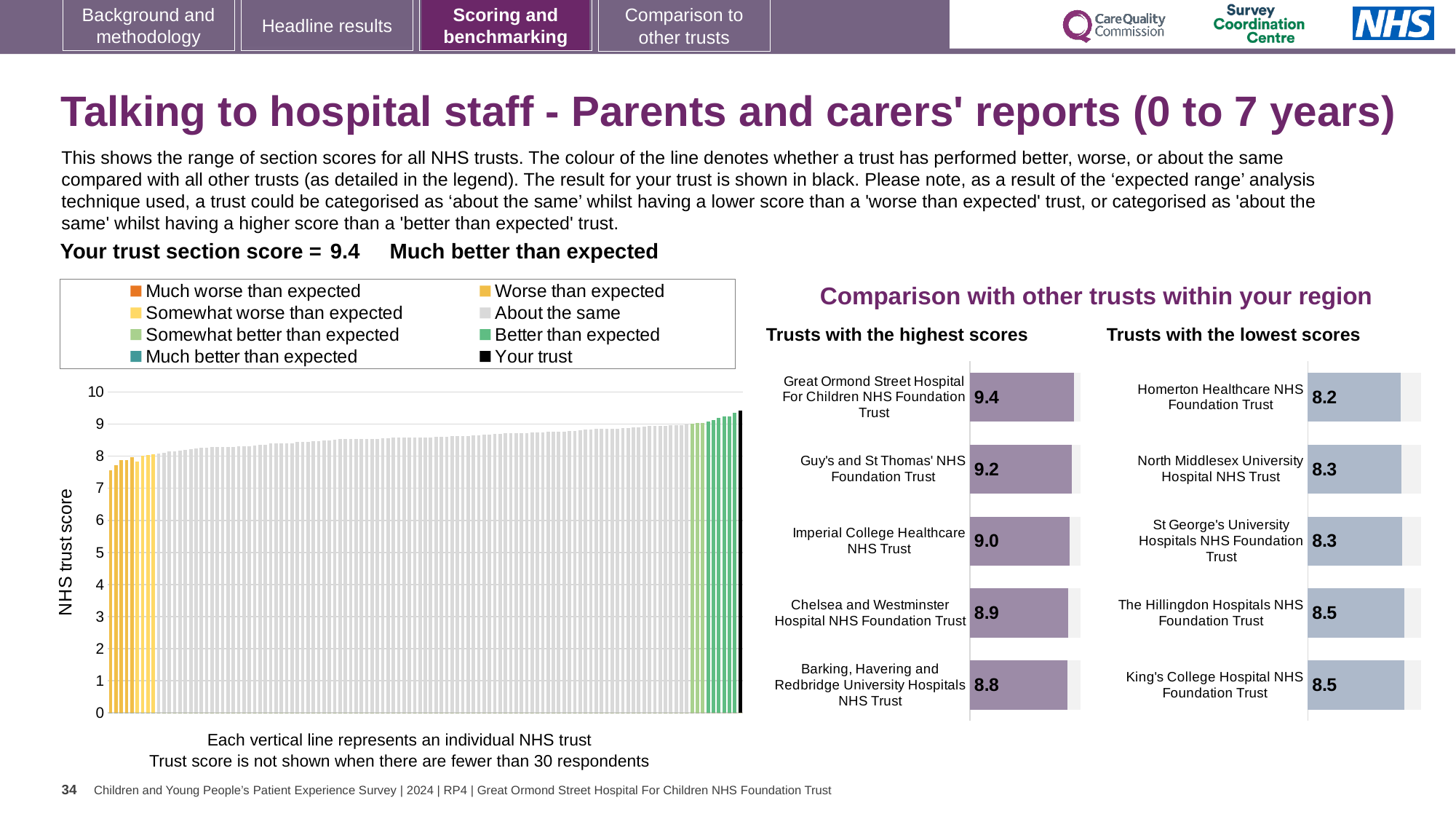
In the 'Trusts with the lowest scores' chart, which trust has the lowest score? Homerton Healthcare NHS Foundation Trust In the 'Trusts with the highest scores' chart, what is the score for Imperial College Healthcare NHS Trust? 9.0 In the 'Trusts with the lowest scores' chart, what is the difference between the scores of King's College Hospital NHS Foundation Trust and Homerton Healthcare NHS Foundation Trust? 0.3 In the 'Trusts with the lowest scores' chart, which has the higher score: The Hillingdon Hospitals NHS Foundation Trust or North Middlesex University Hospital NHS Trust? The Hillingdon Hospitals NHS Foundation Trust In the large chart on the left showing all NHS trusts, how many entries does the legend list? 8 In the 'Trusts with the lowest scores' chart, what is the score for Homerton Healthcare NHS Foundation Trust? 8.2 In the 'Trusts with the highest scores' chart, what is the difference between the scores of Great Ormond Street Hospital For Children NHS Foundation Trust and Barking, Havering and Redbridge University Hospitals NHS Trust? 0.6 In the 'Trusts with the highest scores' chart, what is the score for Chelsea and Westminster Hospital NHS Foundation Trust? 8.9 What kind of chart is the large chart on the left showing all NHS trusts? bar chart In the large chart on the left showing all NHS trusts, do the values rise or fall from left to right? rise In the 'Trusts with the highest scores' chart, which trust has the highest score? Great Ormond Street Hospital For Children NHS Foundation Trust In the 'Trusts with the lowest scores' chart, how many trusts are shown? 5